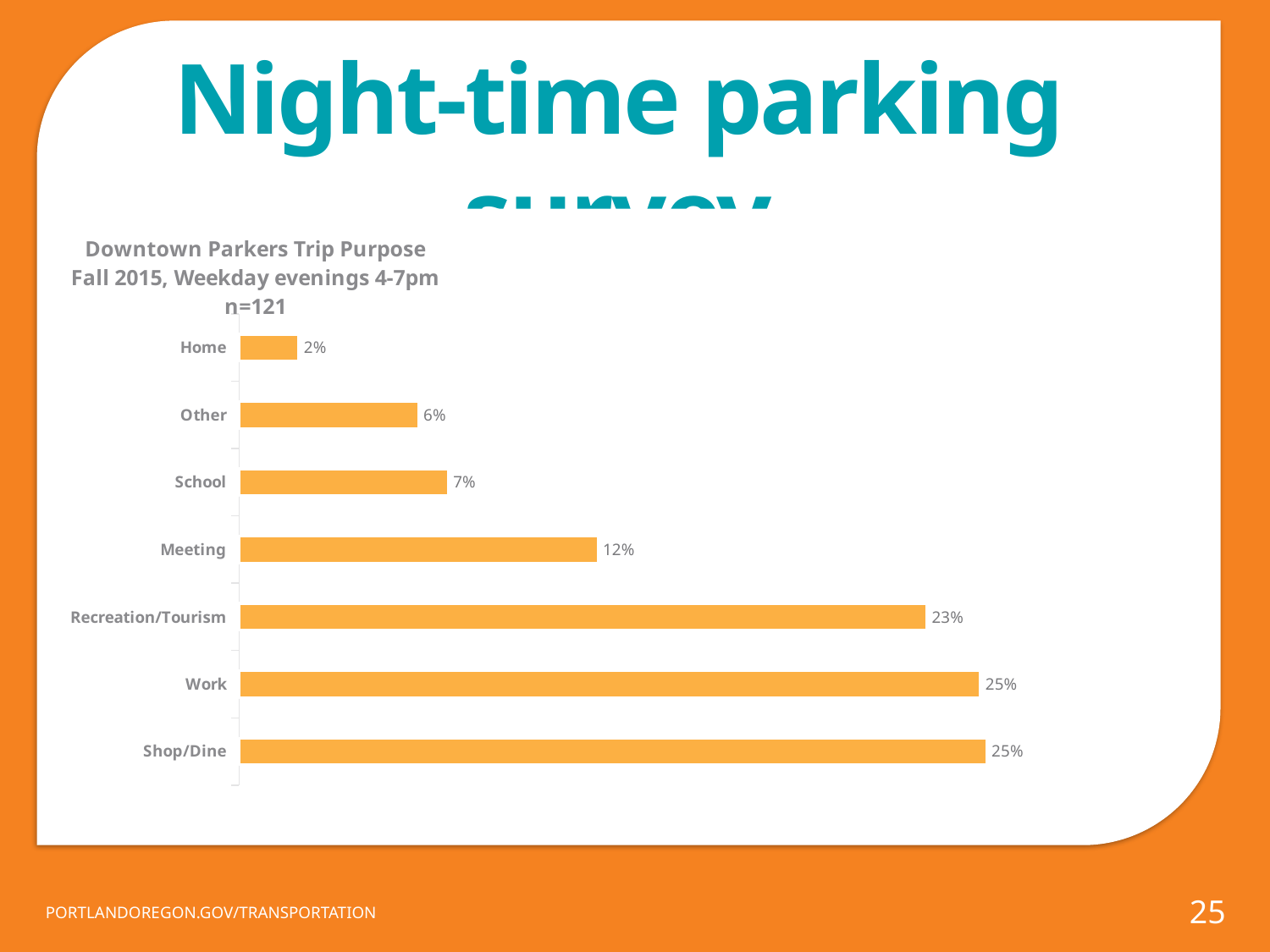
What is the value shown for Meeting? 12% Do the bar values increase or decrease going from the top category (Home) to the bottom category (Shop/Dine)? Increase Which is larger, the value for Meeting or the value for School? Meeting How many trip purpose categories are shown in the chart? 7 What is the difference between the Recreation/Tourism value and the Meeting value? 11 percentage points What is the value for School? 7% What kind of chart is shown on the slide? Bar chart Which trip purpose has the lowest percentage? Home What percentage of downtown parkers gave Shop/Dine as their trip purpose? 25% What is the difference between the Other value and the Home value? 4 percentage points What percentage is shown for Recreation/Tourism? 23% What sample size (n) is stated in the chart title? n=121